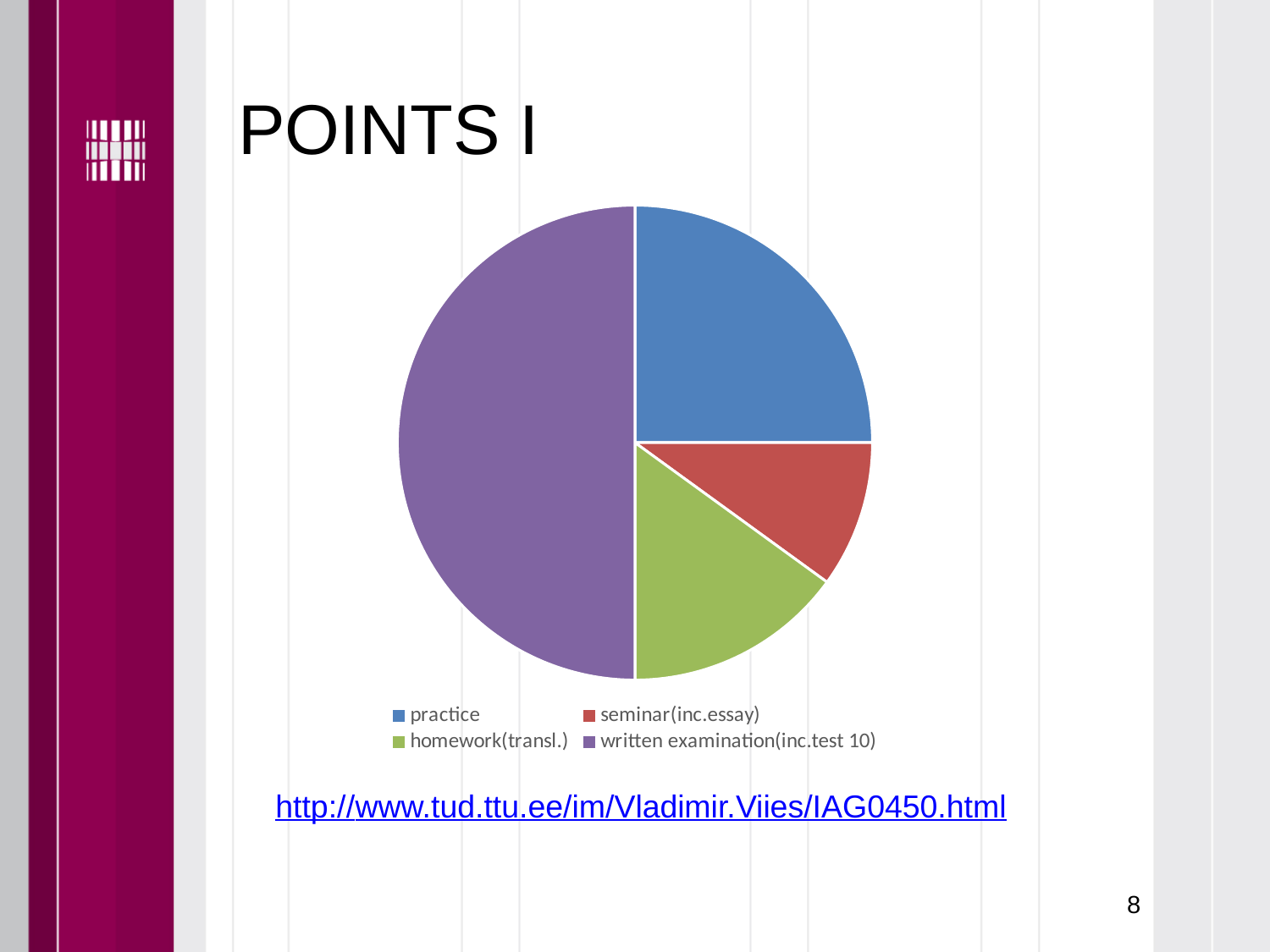
Which slice is larger, practice or homework(transl.)? practice Which category has the smallest slice of the pie chart? seminar(inc.essay) Which category has the largest slice of the pie chart? written examination(inc.test 10) Which slice is larger, written examination(inc.test 10) or practice? written examination(inc.test 10) What is the title of the slide containing the pie chart? POINTS I What kind of chart is shown on the slide? pie chart How many slices does the pie chart have? 4 What colour is the slice for written examination(inc.test 10) in the pie chart? purple Which slice is larger, homework(transl.) or seminar(inc.essay)? homework(transl.) How many entries does the legend of the pie chart list? 4